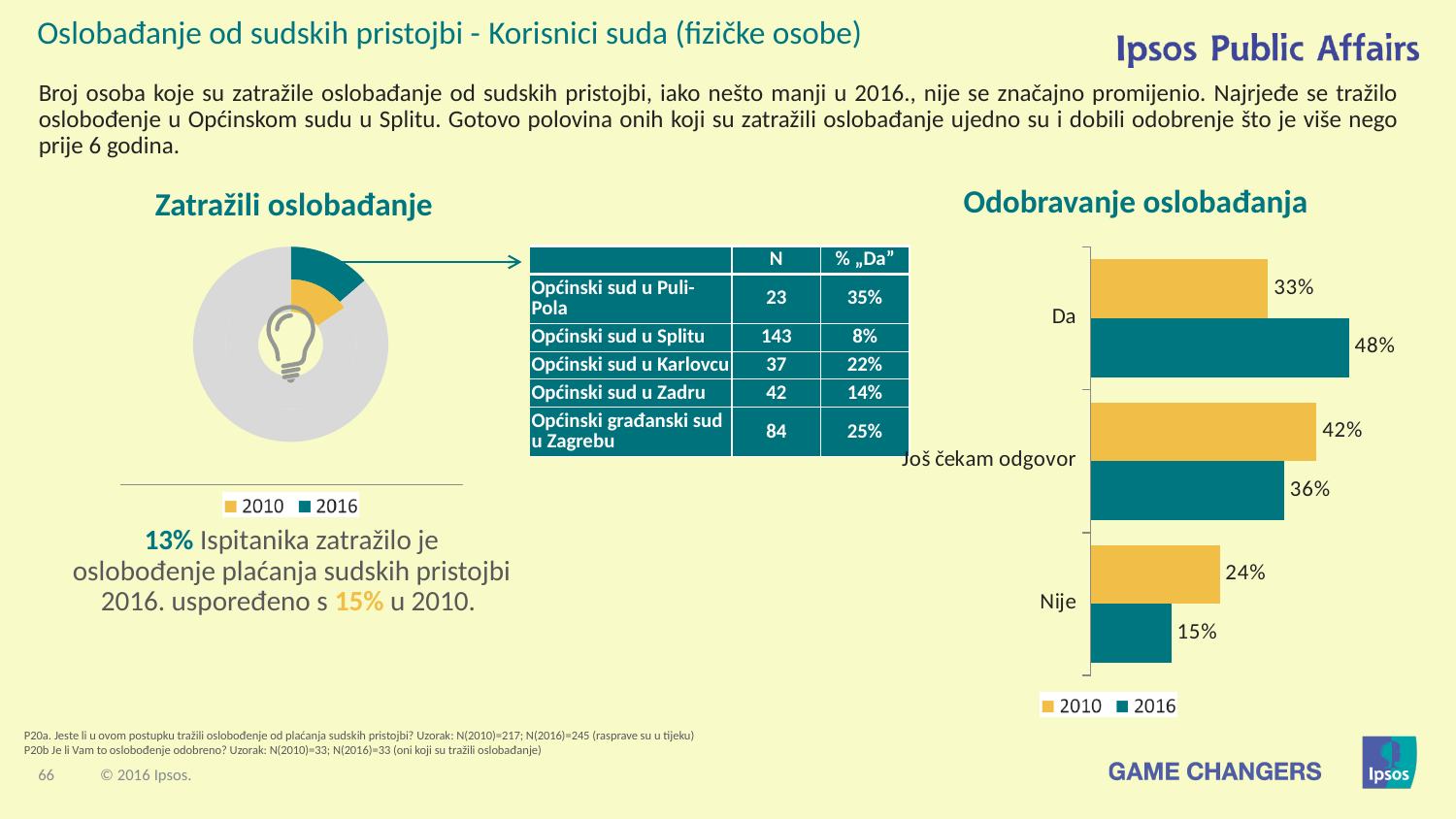
In the 'Odobravanje oslobađanja' chart, which is larger for 'Još čekam odgovor': the 2010 value or the 2016 value? 2010 In the 'Odobravanje oslobađanja' chart, which category has the lowest value for 2010? Nije What kind of chart is the 'Odobravanje oslobađanja' chart? Bar chart In the 'Odobravanje oslobađanja' chart, what is the value for 'Još čekam odgovor' in 2016? 36% What kind of chart is the 'Zatražili oslobađanje' chart on the left? Donut chart How many categories are shown in the 'Odobravanje oslobađanja' chart? 3 Which two years are listed in the legend of the 'Zatražili oslobađanje' chart? 2010 and 2016 In the 'Odobravanje oslobađanja' chart, what is the value for 'Da' in 2016? 48% How many series does the legend of the 'Odobravanje oslobađanja' chart list? 2 In the 'Odobravanje oslobađanja' chart, what is the value for 'Nije' in 2010? 24% In the 'Odobravanje oslobađanja' chart, what is the difference between the 2016 and 2010 values for 'Da'? 15 percentage points In the 'Odobravanje oslobađanja' chart, which category has the highest value for 2016? Da